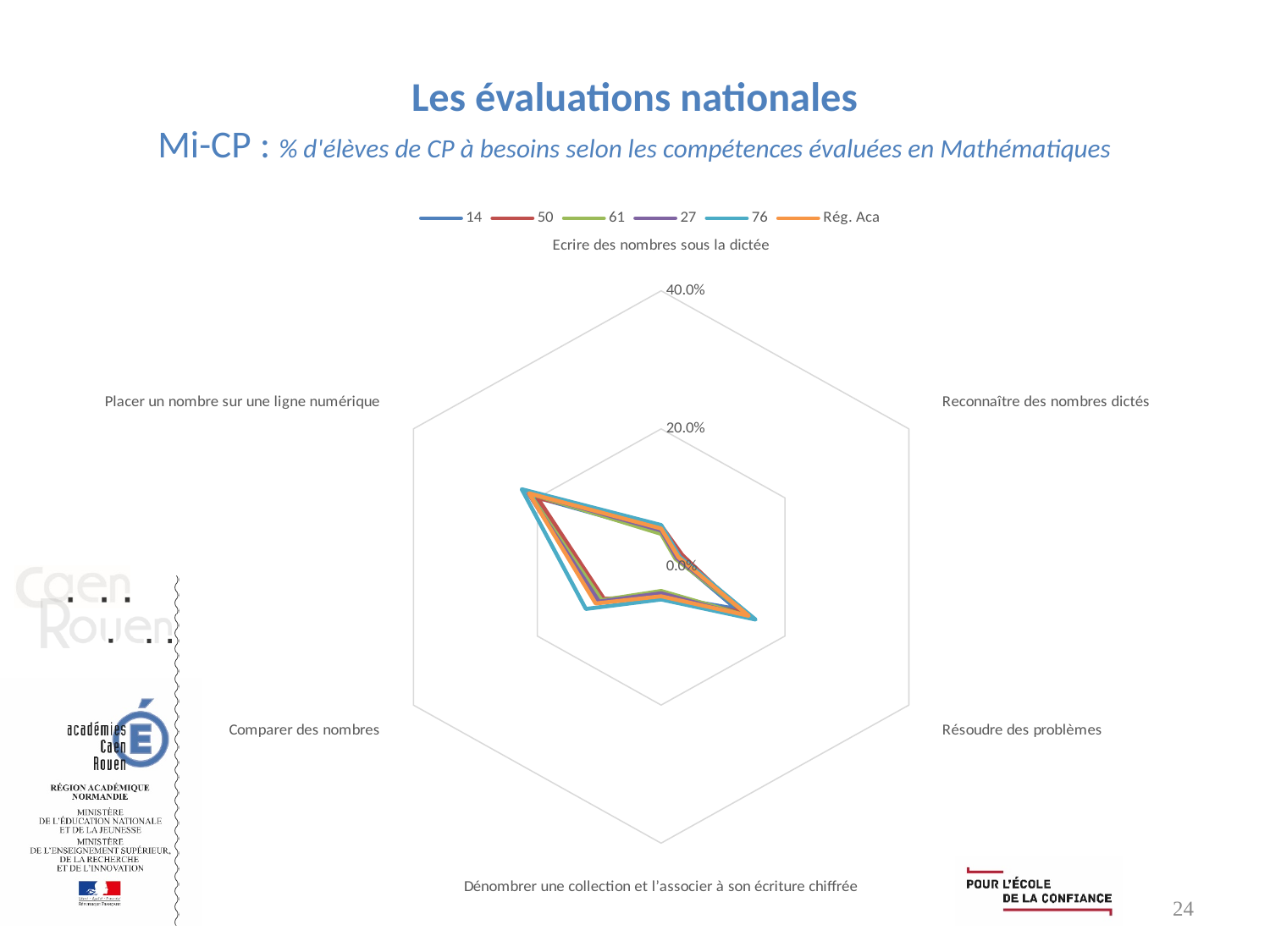
How many series does the legend of the chart list? 6 Which has the larger value: 'Résoudre des problèmes' or 'Dénombrer une collection et l'associer à son écriture chiffrée'? Résoudre des problèmes What is the highest value shown on the chart's axis scale? 40.0% What kind of chart is shown on the slide? Radar chart Is the value for 'Placer un nombre sur une ligne numérique' greater or less than 40.0%? less Which competency has the lowest percentage of pupils with needs across the series? Reconnaître des nombres dictés Which competency has the highest percentage of pupils with needs across the series? Placer un nombre sur une ligne numérique Is the value for 'Ecrire des nombres sous la dictée' greater or less than 20.0%? less Which series is listed last in the chart legend? Rég. Aca Is the value for 'Résoudre des problèmes' greater or less than 20.0%? less How many competency categories (axes) does the radar chart have? 6 Which has the larger value: 'Placer un nombre sur une ligne numérique' or 'Ecrire des nombres sous la dictée'? Placer un nombre sur une ligne numérique